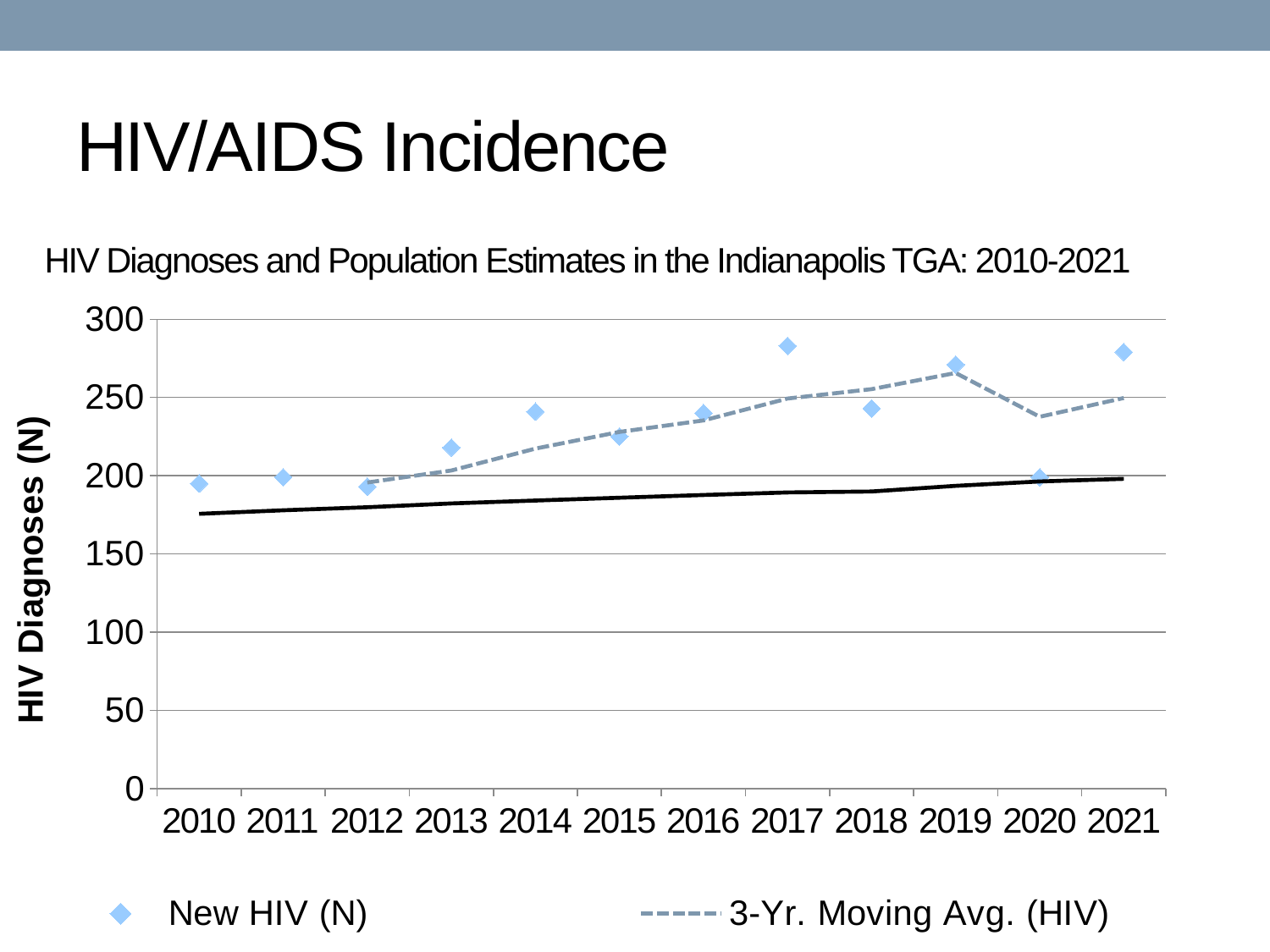
Is the New HIV (N) value for 2014 greater or less than 200? greater Which year has the larger New HIV (N) value, 2017 or 2020? 2017 Does the 3-Yr. Moving Avg. (HIV) line rise or fall from 2012 to 2019? rise Is the New HIV (N) value for 2017 greater or less than 250? greater Is the 3-Yr. Moving Avg. (HIV) value for 2019 greater or less than 250? greater How many years are shown on the x axis of the chart? 12 Which year has the larger New HIV (N) value, 2010 or 2014? 2014 What is the title of the chart? HIV Diagnoses and Population Estimates in the Indianapolis TGA: 2010-2021 How many series does the chart legend list? 2 What is the label of the vertical axis? HIV Diagnoses (N)